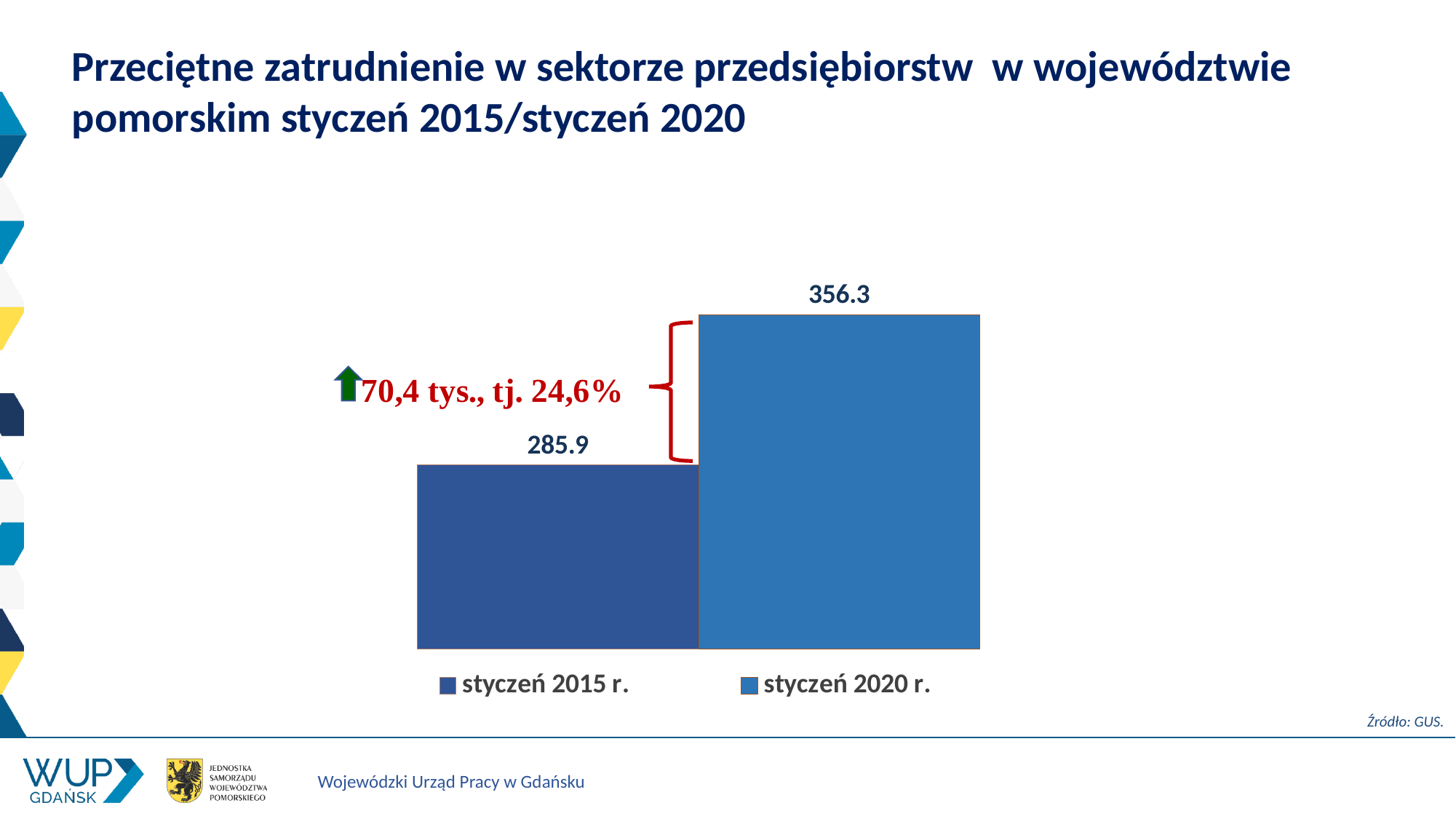
What is the value for styczeń 2020 r.? 356.3 What source is cited for the chart data? GUS Which series has the highest value? styczeń 2020 r. Which series has the higher value, styczeń 2015 r. or styczeń 2020 r.? styczeń 2020 r. How many bars are plotted on the chart? 2 What percentage increase is annotated between the two bars? 24,6% What kind of chart is shown on the slide? bar chart What is the difference between the styczeń 2020 r. value and the styczeń 2015 r. value? 70.4 What is the value for styczeń 2015 r.? 285.9 Do the values rise or fall from styczeń 2015 r. to styczeń 2020 r.? rise How many series does the legend list? 2 Which series has the lowest value? styczeń 2015 r.